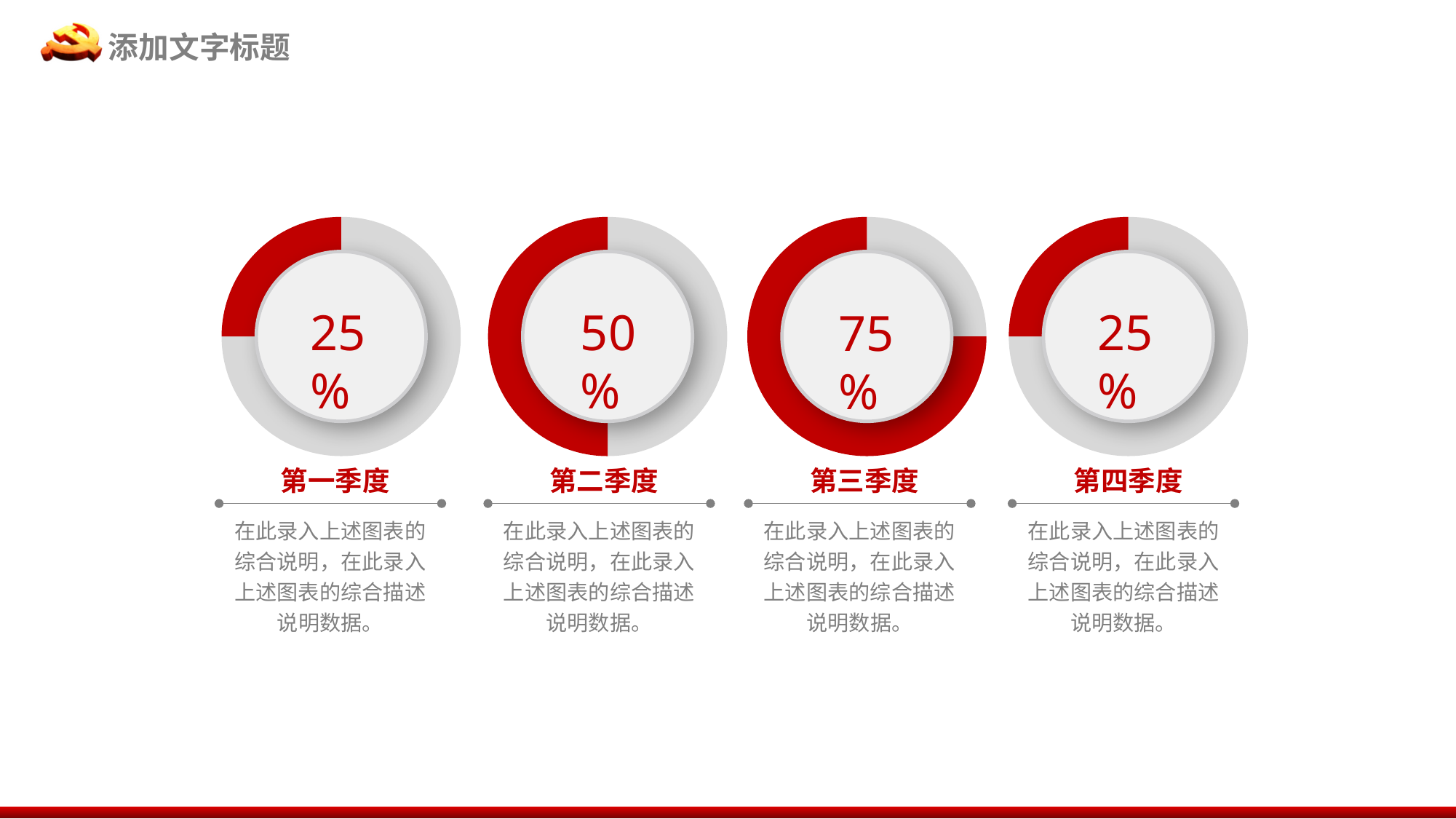
Do the values rise or fall from 第一季度 to 第三季度? Rise What value is shown in the 第一季度 chart? 25% Which quarter's chart shows the highest percentage? 第三季度 Which is larger, the 第二季度 value or the 第三季度 value? 第三季度 What value is shown in the 第三季度 chart? 75% How many ring charts are shown on the slide? 4 What is the difference between the 第二季度 value and the 第四季度 value? 25% What is the difference between the 第三季度 value and the 第一季度 value? 50% What value is shown in the 第四季度 chart? 25% What kind of chart is used for each quarter on the slide? Doughnut chart What colour is the filled portion of each ring chart? Red What value is shown in the 第二季度 chart? 50%